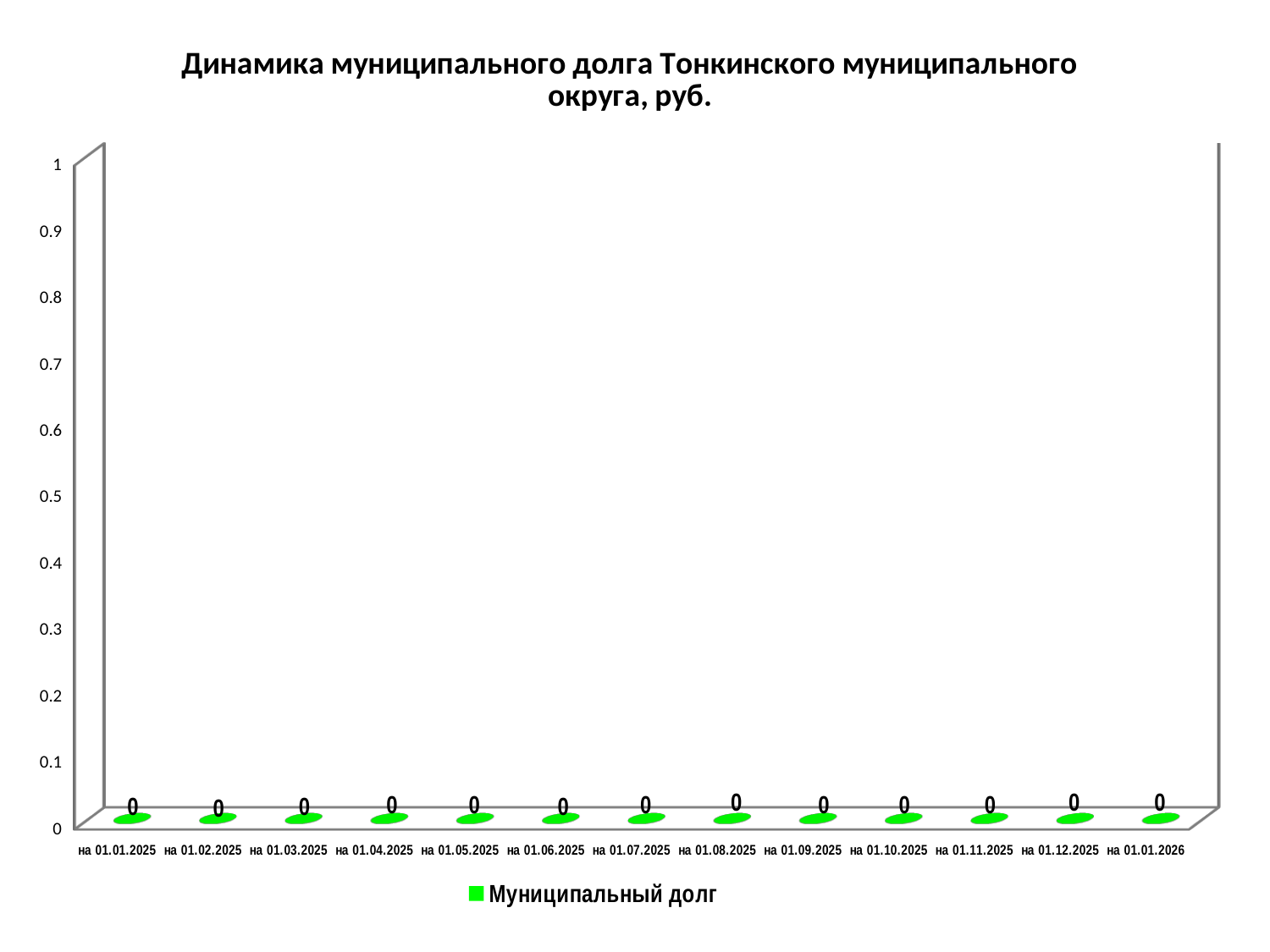
What is the title of the chart? Динамика муниципального долга Тонкинского муниципального округа, руб. What is the value for на 01.10.2025? 0 What is the name of the series in the legend? Муниципальный долг What kind of chart is this? bar chart What is the value for на 01.07.2025? 0 What is the value for на 01.01.2026? 0 What is the value for на 01.01.2025? 0 How many series does the legend list? 1 Is the value for на 01.05.2025 greater or less than 0.1? less Do the values rise, fall or stay the same from на 01.01.2025 to на 01.01.2026? stay the same What is the difference between the values for на 01.01.2025 and на 01.01.2026? 0 How many dates are shown on the x axis? 13